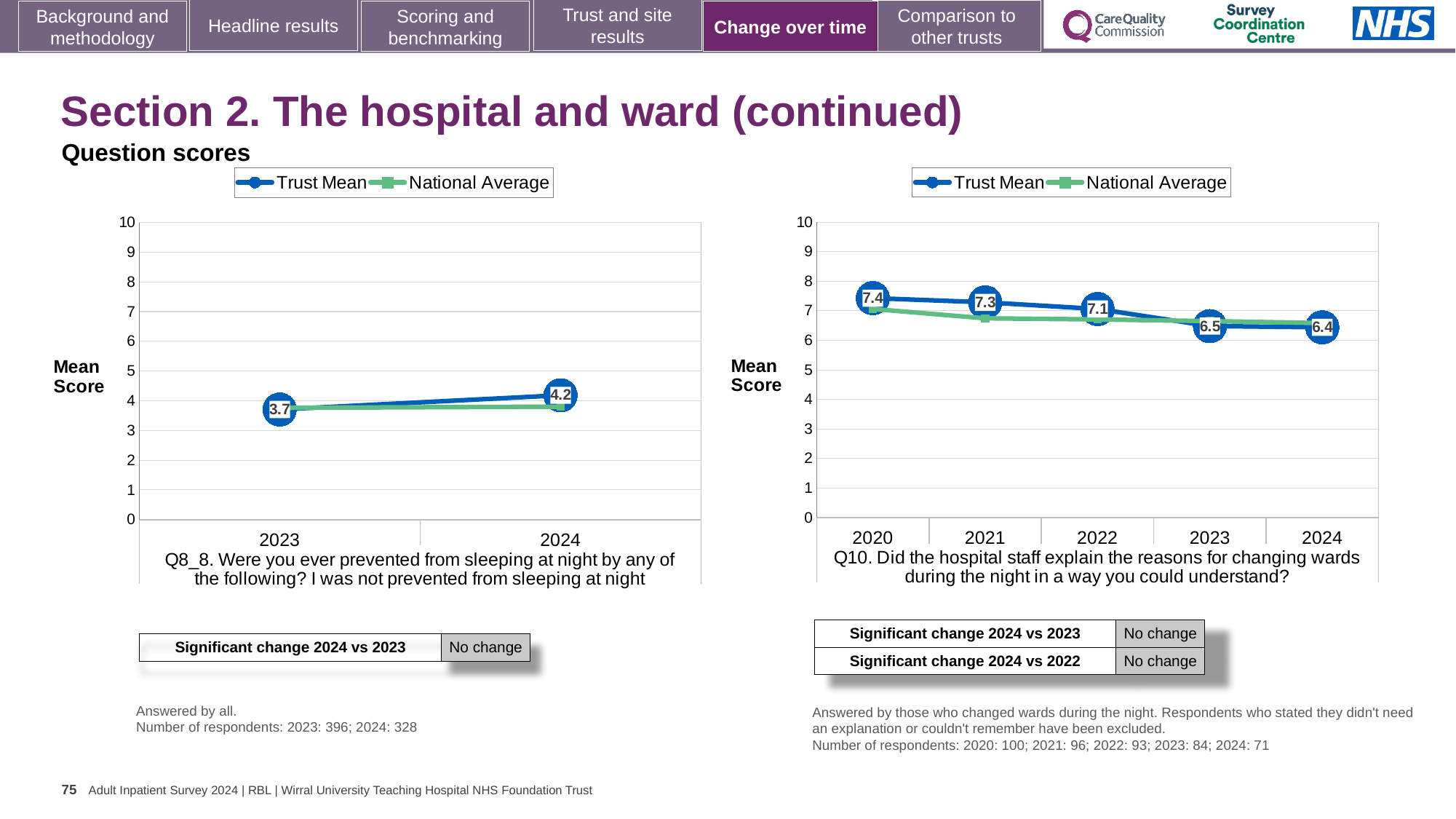
In the right chart (Q10), what is the Trust Mean score for 2023? 6.5 In the left chart (Q8_8), does the Trust Mean rise or fall from 2023 to 2024? rise How many series does the legend of the right chart (Q10) list? 2 In the left chart (Q8_8), what is the Trust Mean score for 2024? 4.2 In the right chart (Q10), which year has the lowest Trust Mean score? 2024 In the right chart (Q10), what is the difference between the Trust Mean in 2020 and in 2024? 1.0 In the right chart (Q10), what is the Trust Mean score for 2020? 7.4 What type of chart is the left chart (Q8_8)? line chart In the left chart (Q8_8), by how much did the Trust Mean change from 2023 to 2024? 0.5 In the right chart (Q10), how many years are plotted on the x axis? 5 In the right chart (Q10), which year has the highest Trust Mean score? 2020 In the left chart (Q8_8), what is the Trust Mean score for 2023? 3.7